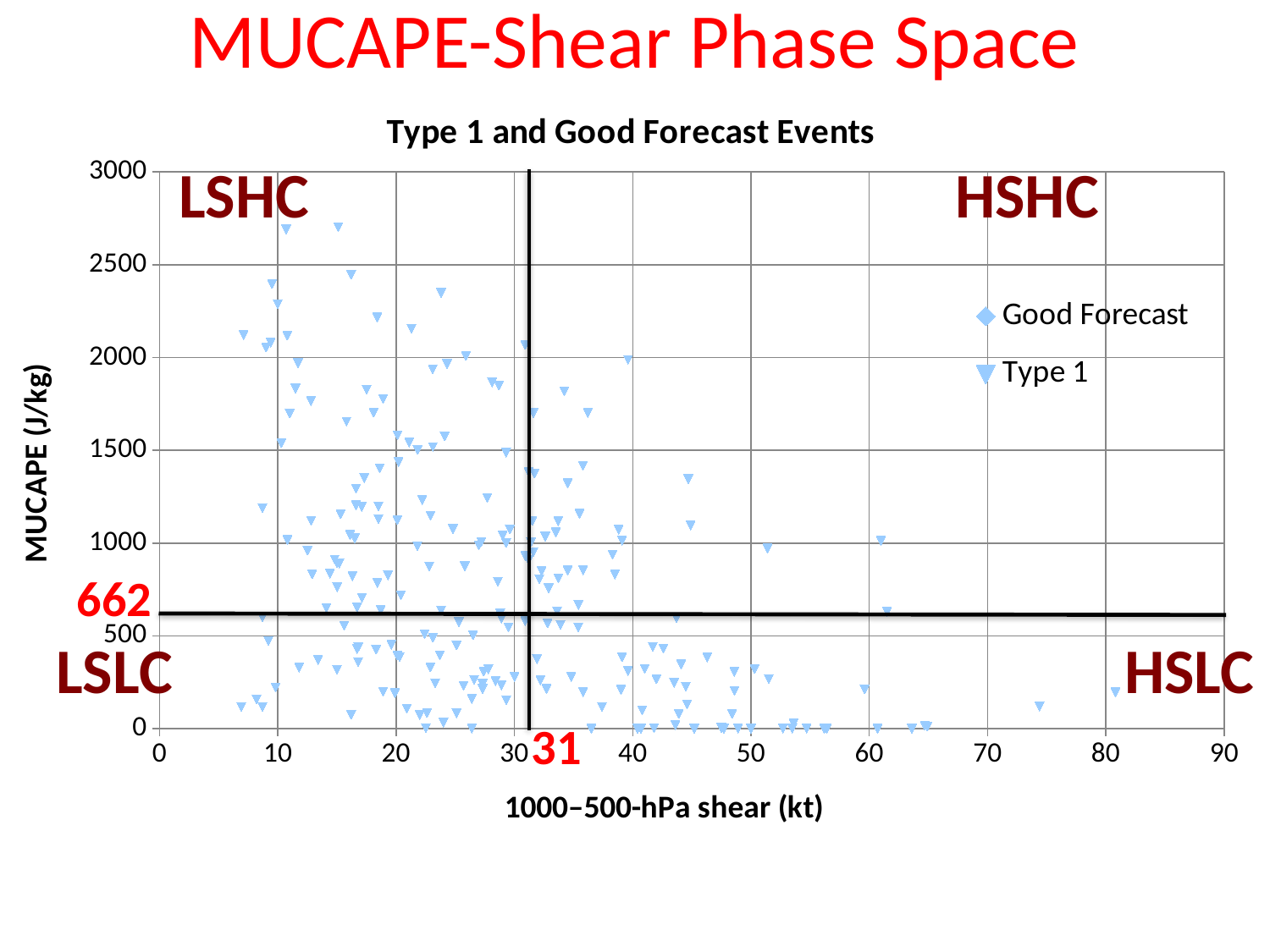
What is the maximum value shown on the x axis? 90 What shear value is marked by the vertical black line on the chart? 31 How many series does the chart legend list? 2 What is the label of the y axis? MUCAPE (J/kg) Which quadrant label appears in the upper-left region of the chart? LSHC What kind of chart is shown on the slide? Scatter chart Which quadrant label appears in the lower-right region of the chart? HSLC What MUCAPE value is marked by the horizontal black line on the chart? 662 What is the title of the chart? Type 1 and Good Forecast Events What is the label of the x axis? 1000–500-hPa shear (kt) What is the maximum value shown on the y axis? 3000